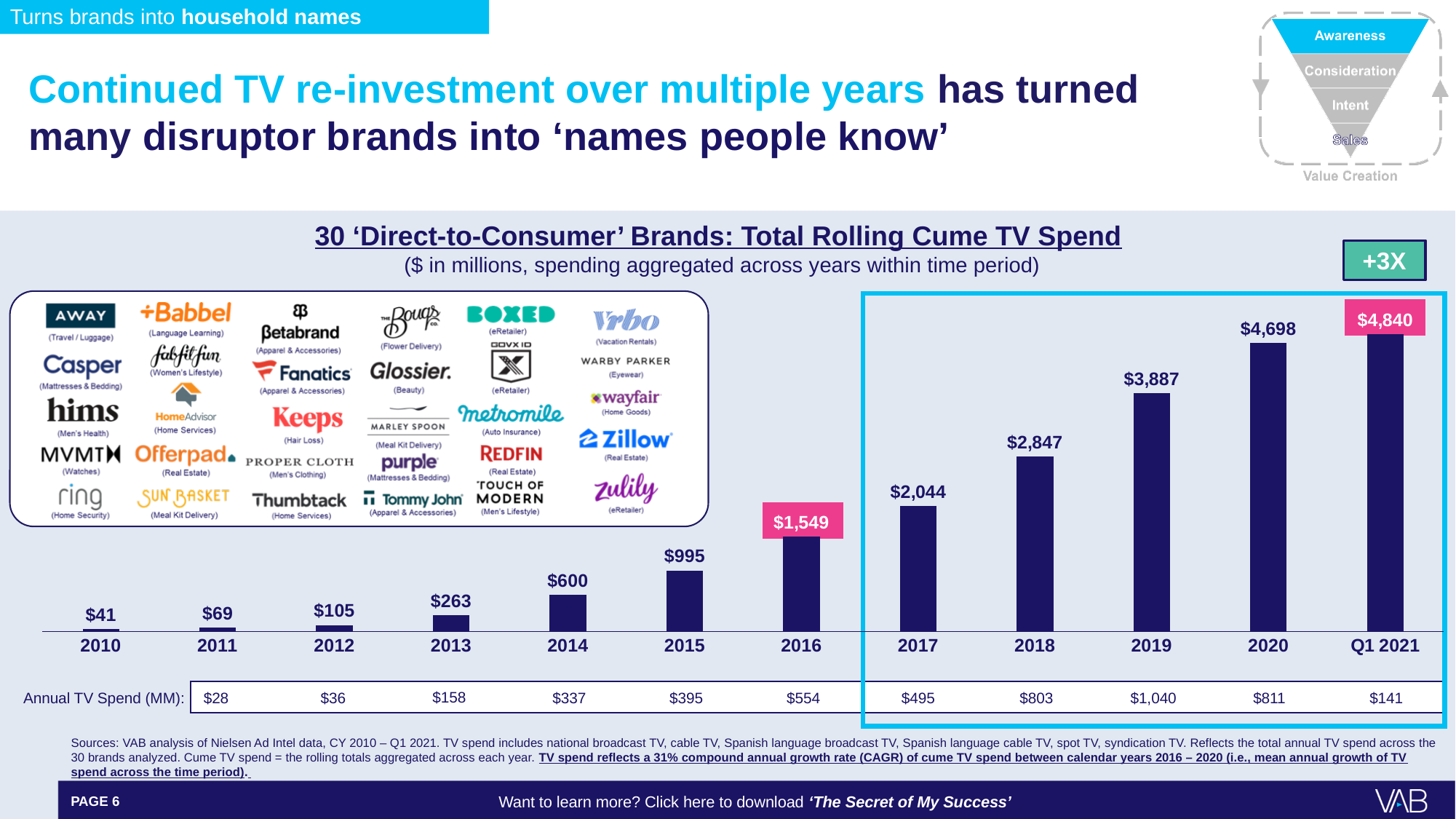
What is the difference between the cume TV spend in 2017 and in 2016? $495 How many time periods are shown on the x axis of the chart? 12 Which period has the lowest total rolling cume TV spend? 2010 What kind of chart is used to show the total rolling cume TV spend? Bar chart What is the total rolling cume TV spend shown for 2013? $263 Which period has the highest total rolling cume TV spend? Q1 2021 What is the total rolling cume TV spend shown for Q1 2021? $4,840 Which is larger, the cume TV spend in 2015 or in 2014? 2015 What annual TV spend (MM) is listed below the chart for 2019? $1,040 What is the total rolling cume TV spend shown for 2016? $1,549 Do the cume TV spend values rise or fall from 2010 to Q1 2021? Rise What is the difference between the cume TV spend in 2020 and in 2019? $811